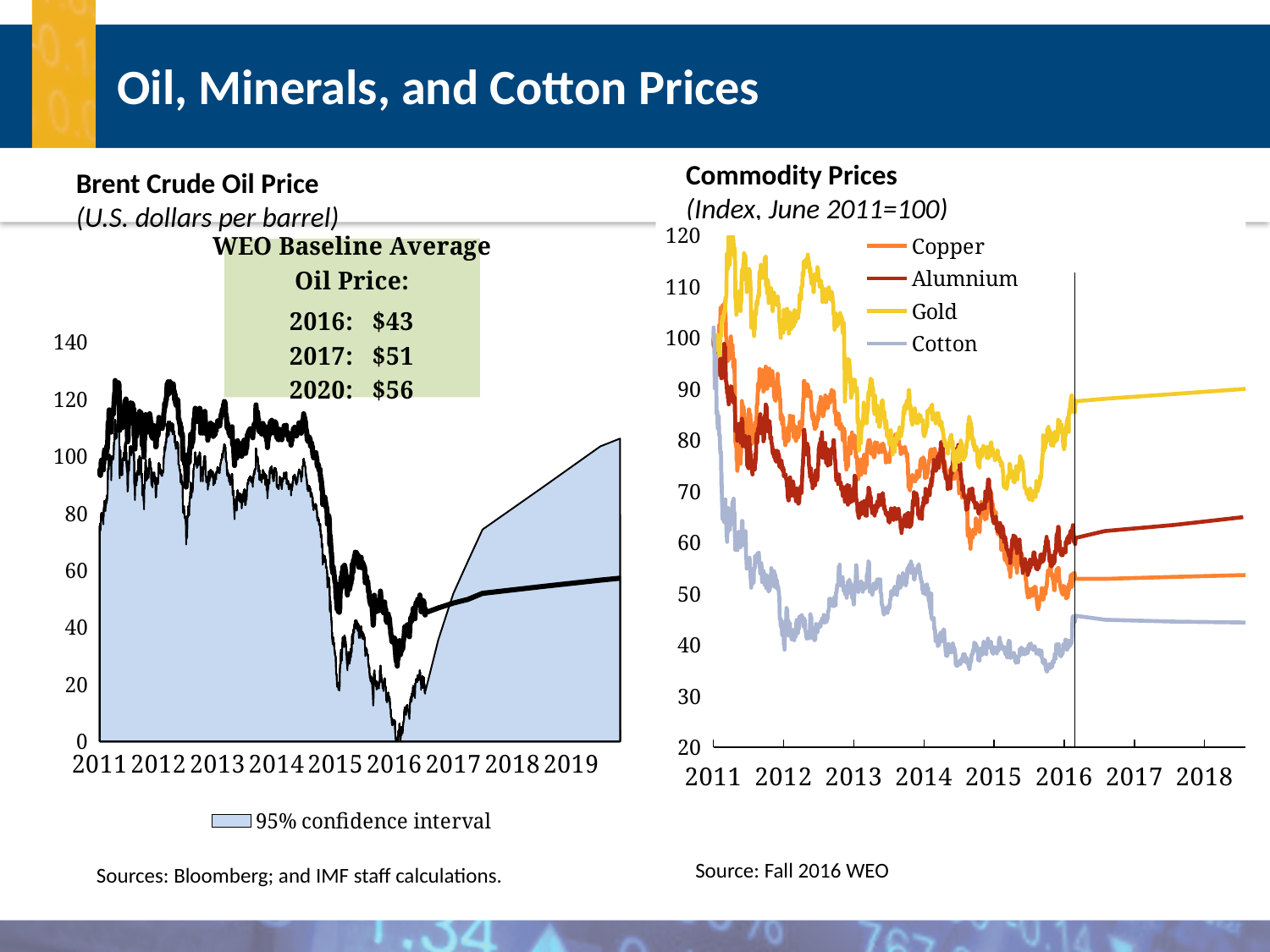
On the Commodity Prices chart, which series has the lowest value at the end of 2018? Cotton On the Commodity Prices chart, is the value for Cotton at the end of 2018 greater or less than 50? less On the Brent Crude Oil Price chart, does the oil price rise or fall between 2014 and 2016? fall What kind of chart is the Commodity Prices chart? line chart On the Brent Crude Oil Price chart, what is the WEO baseline average oil price for 2020? $56 On the Commodity Prices chart, how many series does the legend list? 4 On the Brent Crude Oil Price chart, what is the WEO baseline average oil price for 2016? $43 On the Commodity Prices chart, which is higher at the end of 2018, Aluminium or Copper? Aluminium On the Brent Crude Oil Price chart, how many year labels are shown on the x axis? 9 On the Commodity Prices chart, which series has the highest value at the end of 2018? Gold On the Brent Crude Oil Price chart, what is the difference between the WEO baseline average oil price for 2020 and for 2016? $13 On the Brent Crude Oil Price chart, what is the WEO baseline average oil price for 2017? $51